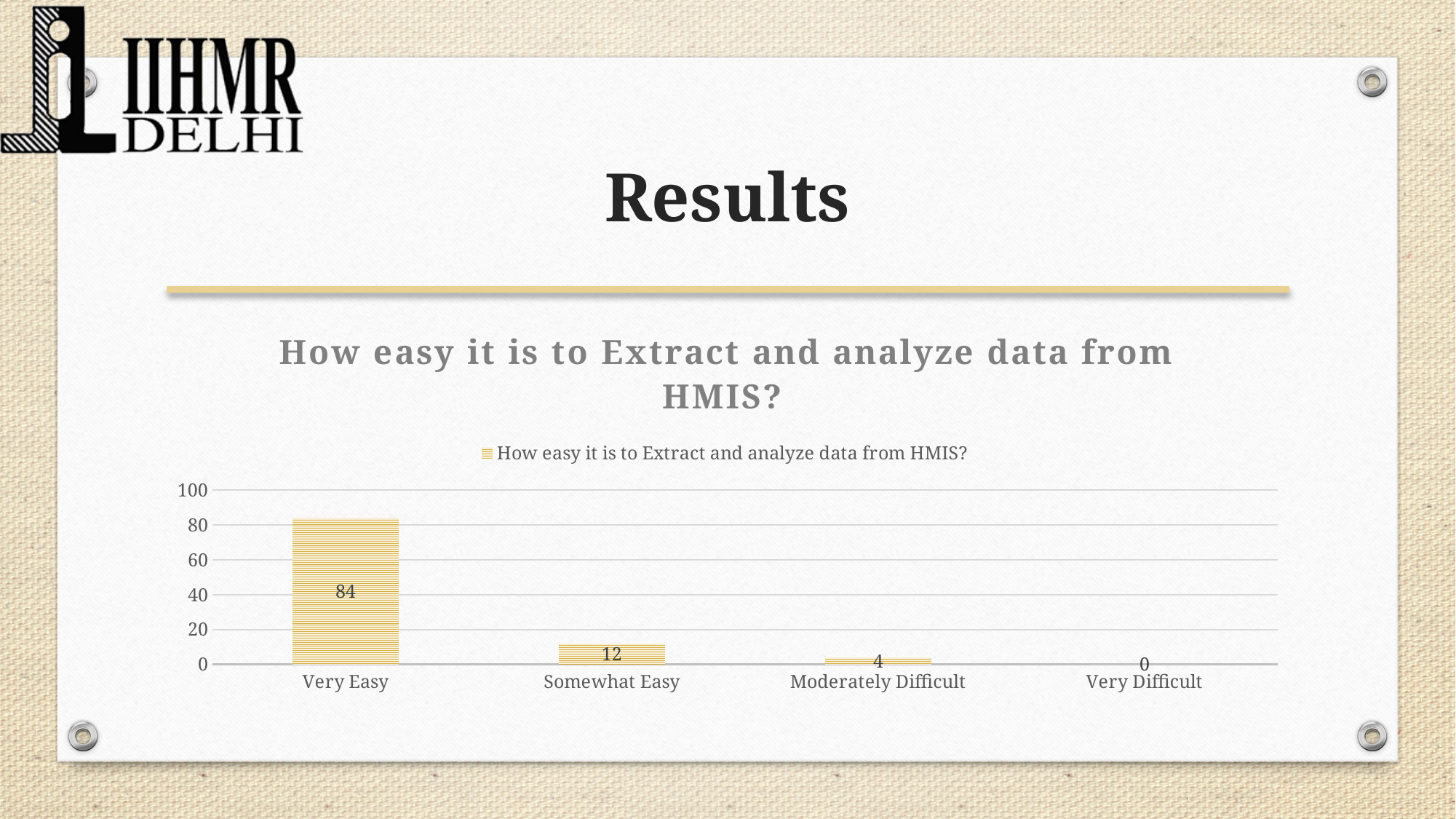
Which category has the highest value? Very Easy What is the value for Very Easy? 84 What is the value for Somewhat Easy? 12 What is the value for Moderately Difficult? 4 What is the difference between the values for Very Easy and Somewhat Easy? 72 What is the title of the chart? How easy it is to Extract and analyze data from HMIS? Which category has the lowest value? Very Difficult What is the value for Very Difficult? 0 How many categories are shown on the x axis? 4 Which is larger, the value for Somewhat Easy or the value for Moderately Difficult? Somewhat Easy What kind of chart is shown? bar chart Is the value for Very Easy greater or less than 80? greater